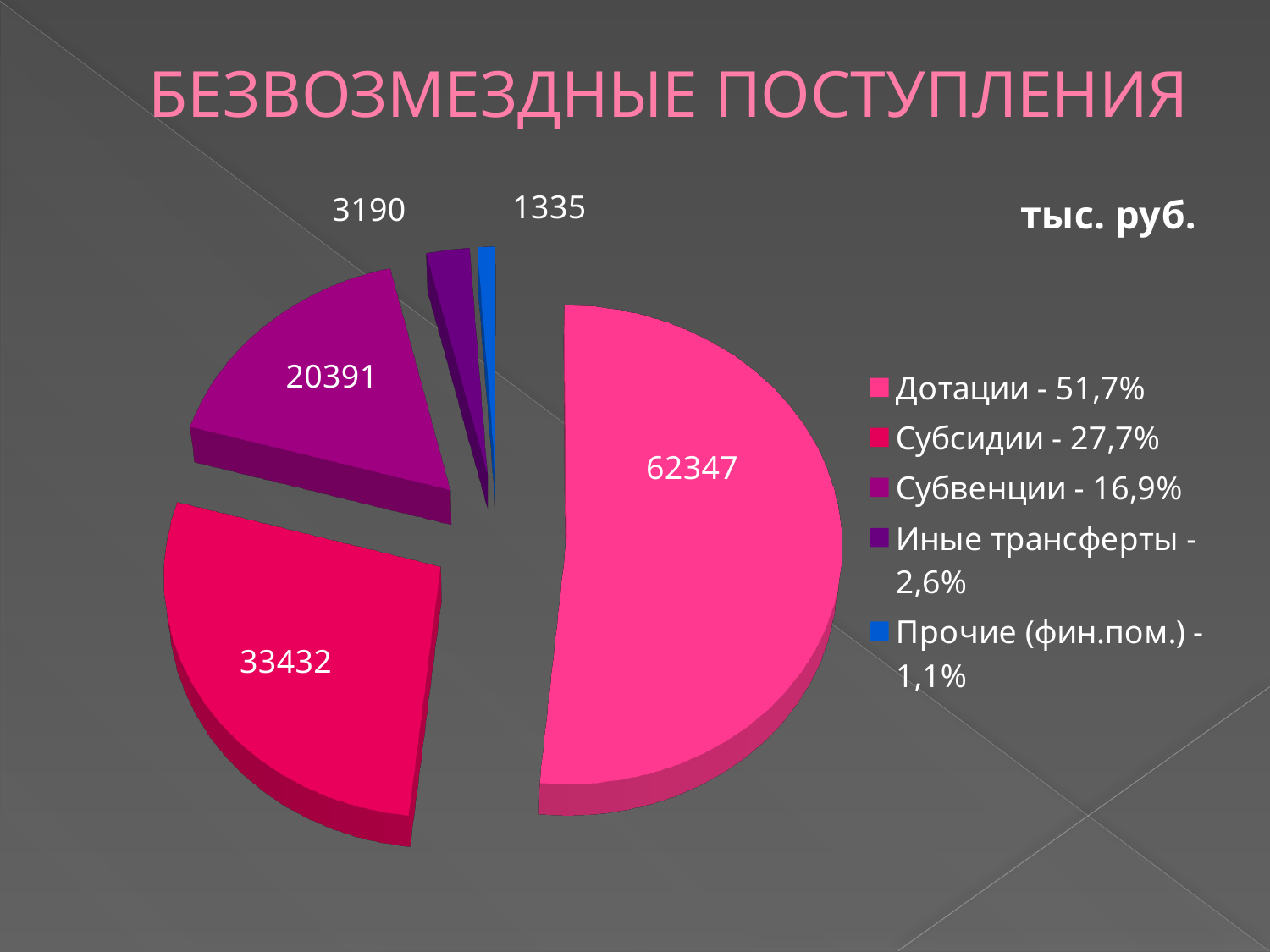
What share of the pie does Субвенции represent, according to the legend? 16,9% What kind of chart is shown on the slide? pie chart Which is larger, the value for Субвенции or the value for Иные трансферты? Субвенции Which category has the largest slice of the pie? Дотации What is the difference between the values for Дотации and Субсидии? 28915 What is the value for Прочие (фин.пом.)? 1335 What is the value for Субвенции? 20391 How many slices does the pie chart have? 5 What is the value for Субсидии? 33432 What is the value for Иные трансферты? 3190 What is the value for Дотации? 62347 Which category has the smallest slice of the pie? Прочие (фин.пом.)